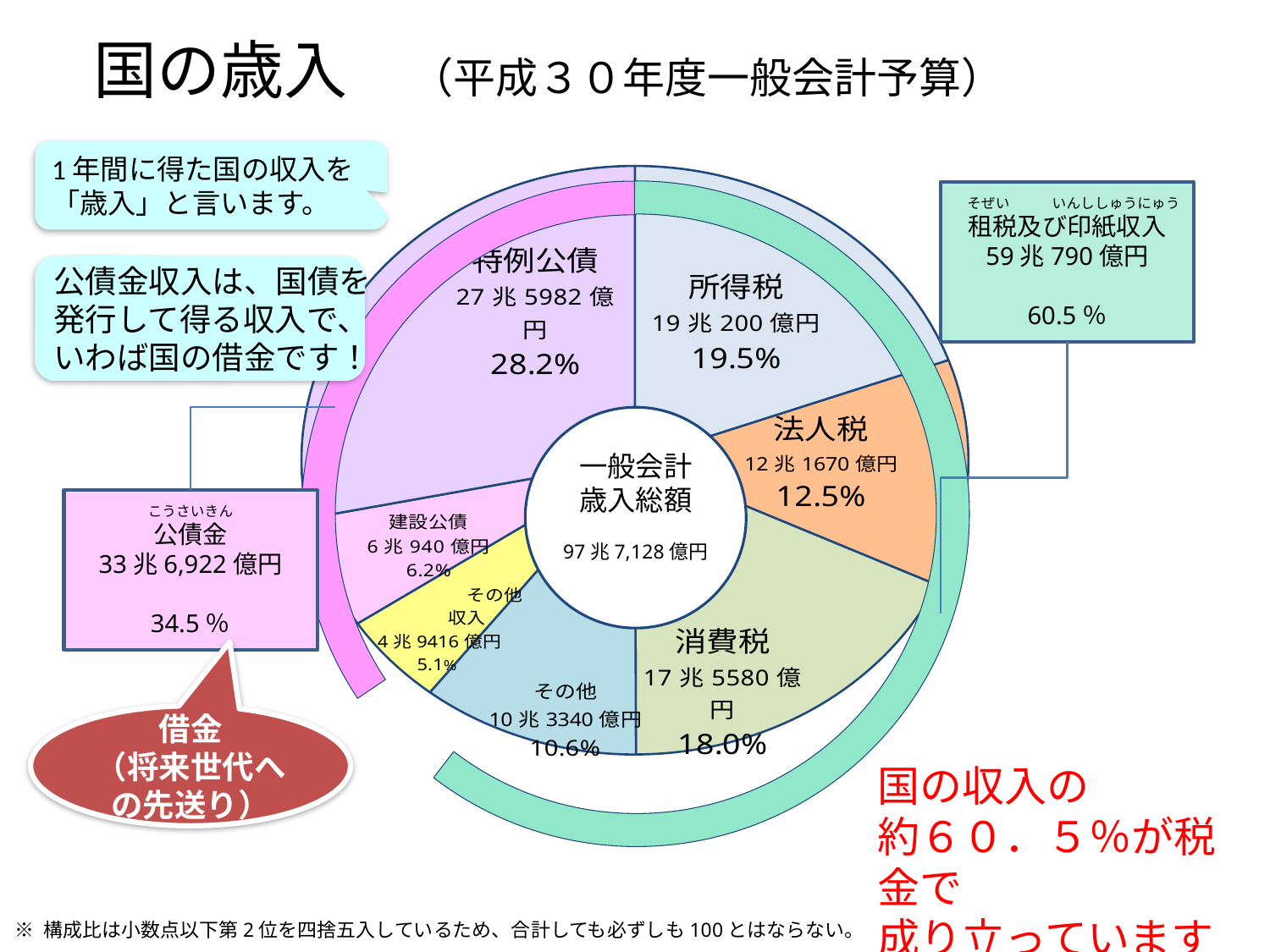
What percentage share does 特例公債 have in the pie chart? 28.2% What is the difference in percentage points between the shares of 特例公債 and 法人税? 15.7 Which slice of the pie chart has the smallest share? その他収入 What percentage share does 建設公債 have in the pie chart? 6.2% Which has a larger share in the pie chart, 所得税 or 消費税? 所得税 What percentage share does 消費税 have in the pie chart? 18.0% Which slice of the pie chart has the largest share? 特例公債 What is the amount shown for 法人税 in the pie chart? 12兆1670億円 What is the amount shown for 所得税 in the pie chart? 19兆200億円 What kind of chart is shown on the slide? pie chart What total amount is shown in the centre of the pie chart (一般会計歳入総額)? 97兆7,128億円 How many slices does the pie chart have? 7